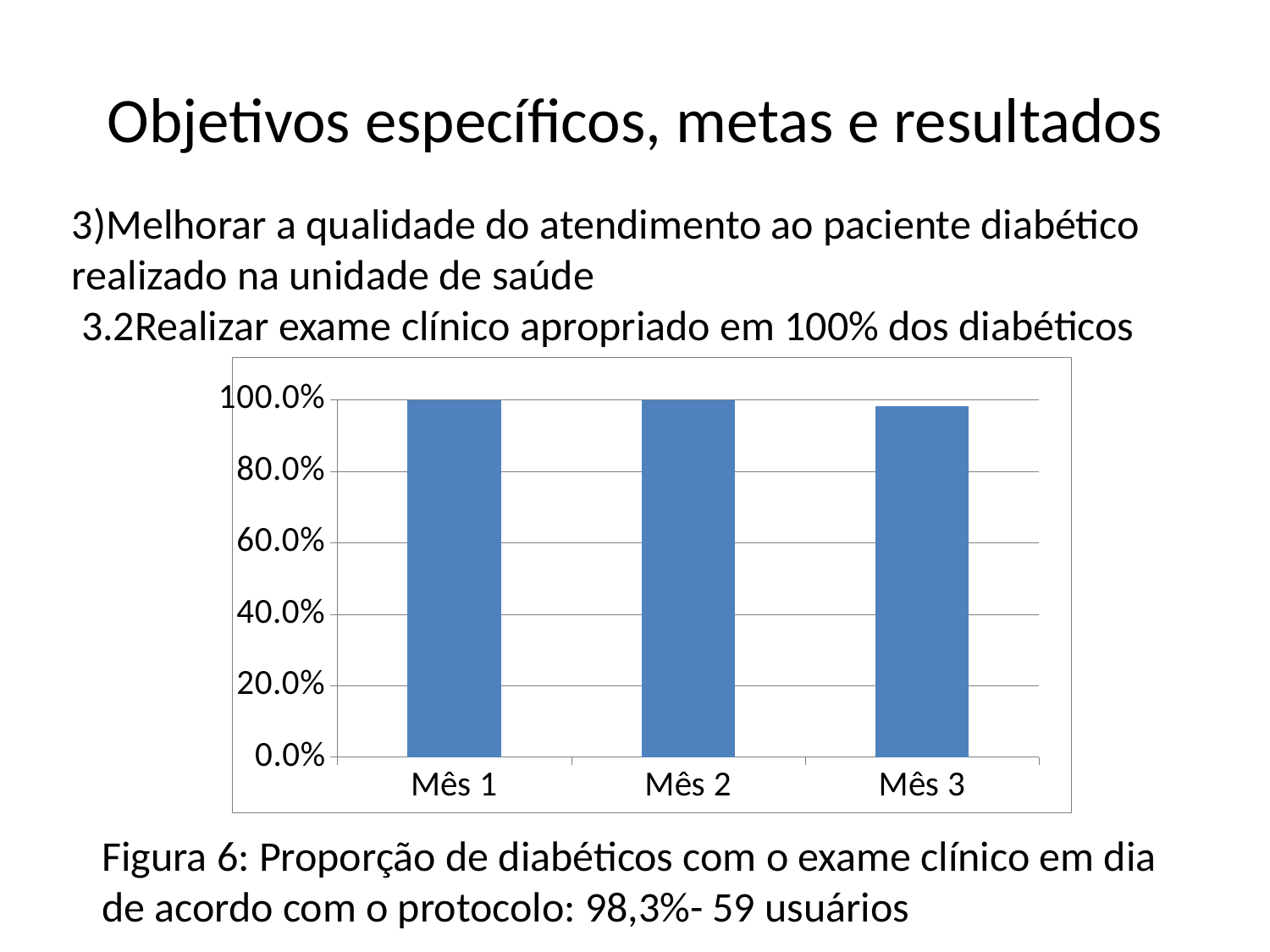
Is the value for Mês 3 greater or less than 80.0%? greater What type of chart is shown on the slide? bar chart What is the value for Mês 2 in the chart? 100.0% What is the label of the first category on the x axis of the chart? Mês 1 What is the value for Mês 1 in the chart? 100.0% Is the value for Mês 1 greater or less than 60.0%? greater Which is larger, the value for Mês 1 or the value for Mês 3? Mês 1 Which month has the lowest bar in the chart? Mês 3 What is the highest tick label shown on the y axis of the chart? 100.0% How many categories (months) are plotted on the x axis of the chart? 3